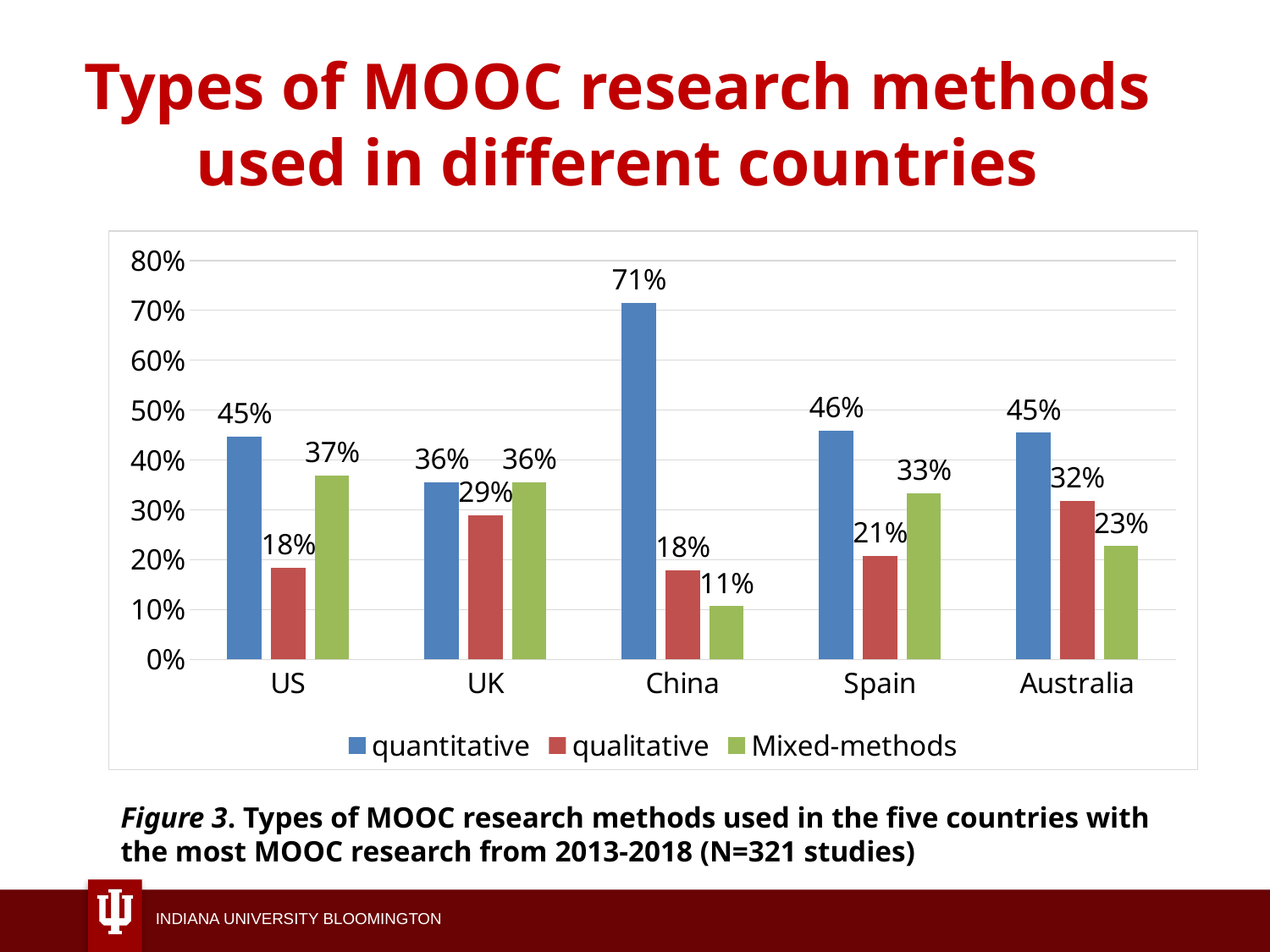
How many countries are shown on the x axis? 5 What kind of chart is shown? bar chart What is the qualitative value for Australia? 32% Is the quantitative value for Spain greater or less than 40%? greater Which colour represents the qualitative series? red What is the Mixed-methods value for Spain? 33% What is the quantitative value for China? 71% Which country has the lowest Mixed-methods value? China Which country has the highest quantitative value? China How many series does the legend list? 3 Which is larger for the UK: the qualitative value or the Mixed-methods value? Mixed-methods What is the difference between the quantitative and qualitative values for China? 53%